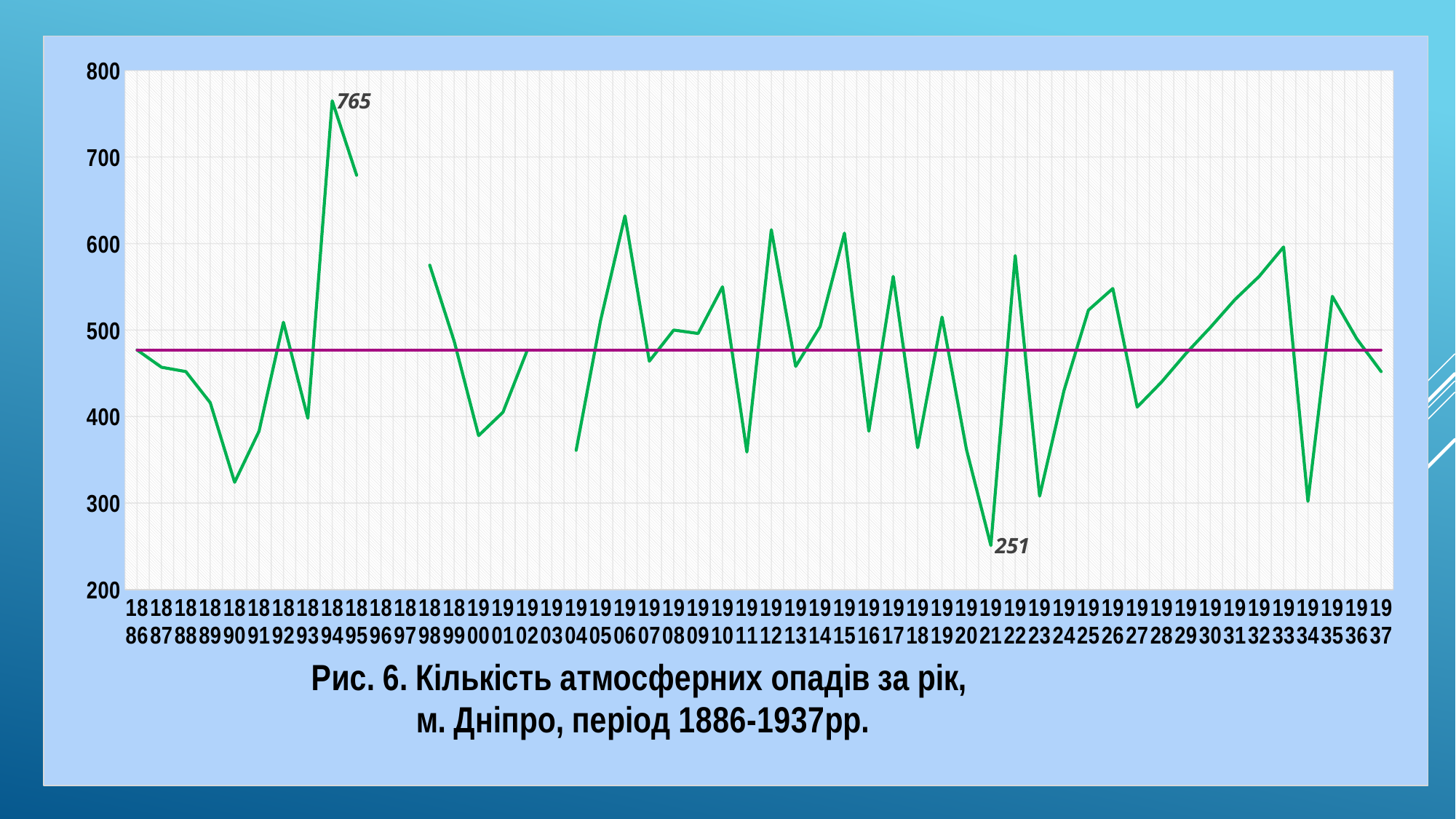
Is the value for 1934 greater or less than 400? less Is the value for 1890 greater or less than 400? less In which year does the chart show its lowest value, 251? 1921 Is the value for 1906 greater or less than 600? greater What is the difference between the labelled maximum (765) and the labelled minimum (251)? 514 What kind of chart is shown on the slide? line chart What is the highest annual precipitation value labelled on the chart? 765 What is the lowest annual precipitation value labelled on the chart? 251 In which year does the chart show its highest value, 765? 1894 Which year has the larger value, 1894 or 1921? 1894 What is the caption (title) given for the chart? Рис. 6. Кількість атмосферних опадів за рік, м. Дніпро, період 1886-1937рр.